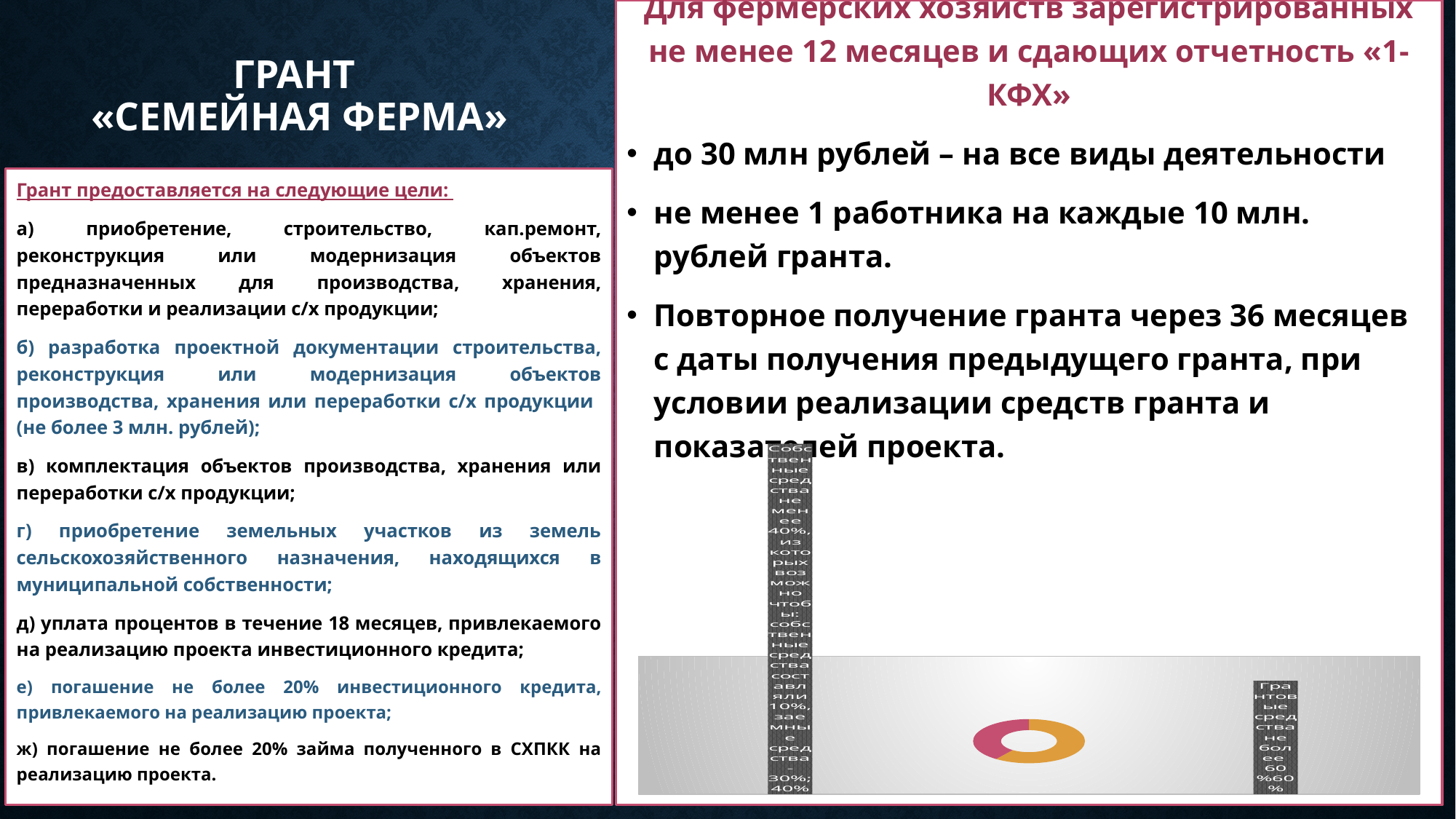
In the doughnut chart, what share is labelled for own funds (Собственные средства)? 40% What kind of chart is shown at the bottom right of the slide? pie chart (doughnut) How many slices does the doughnut chart at the bottom right have? 2 Which slice of the doughnut chart is the smallest? Собственные средства (40%) In the doughnut chart, what is the difference between the grant funds share and the own funds share? 20% Which slice of the doughnut chart is the largest? Грантовые средства (60%) Which colour is the larger slice of the doughnut chart? orange According to the doughnut chart label, what is the maximum share of grant funds? не более 60% In the doughnut chart, which is larger: the share of grant funds or the share of own funds? grant funds (Грантовые средства) According to the own-funds label on the doughnut chart, into what two parts can the 40% own funds be split? собственные средства 10%, заемные средства 30% In the doughnut chart, what share is labelled for grant funds (Грантовые средства)? 60% According to the doughnut chart label, what is the minimum share of own funds? не менее 40%